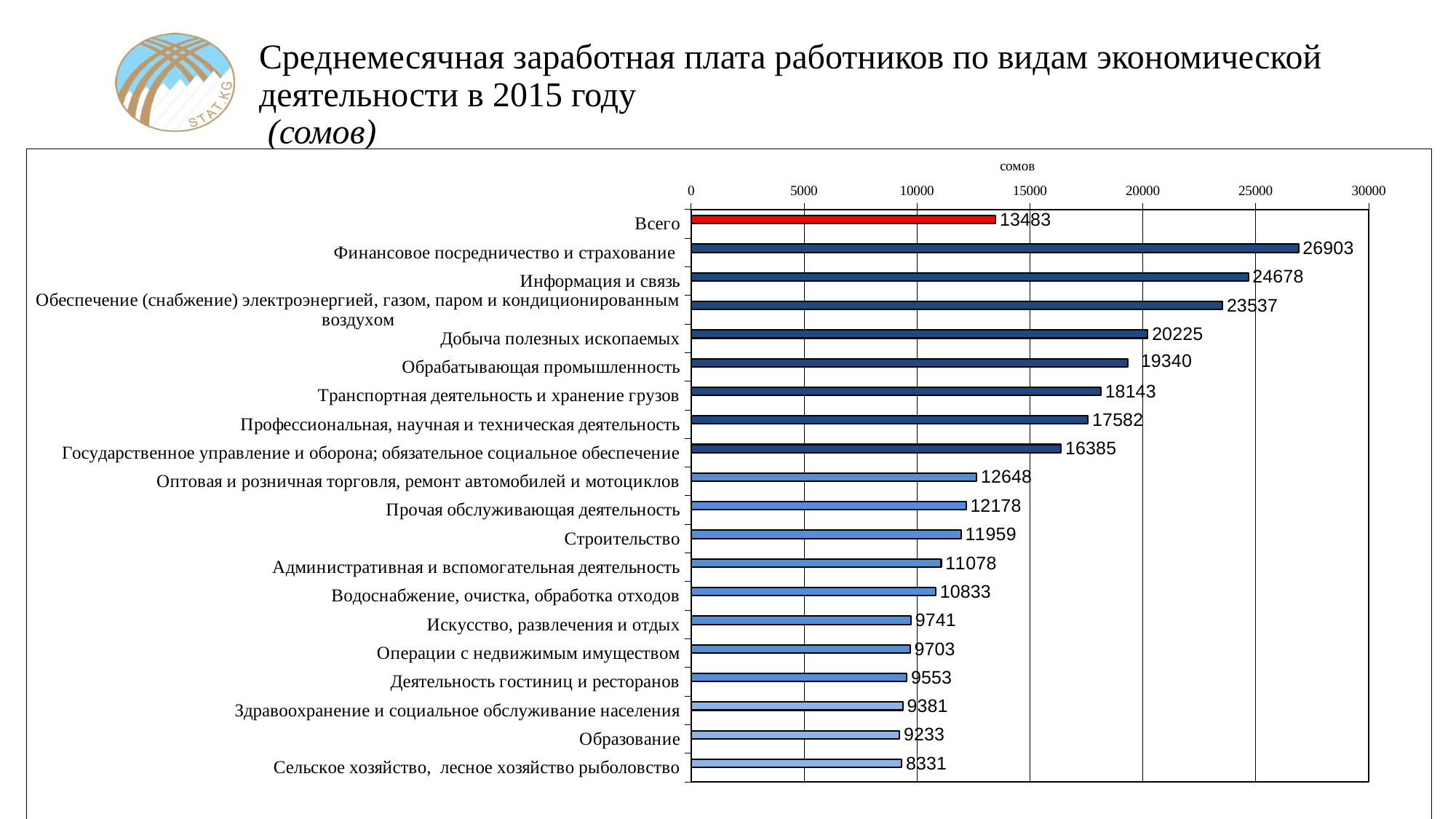
Which bar is coloured red on the chart? Всего What type of chart is shown on the slide? bar chart Is the value for Обрабатывающая промышленность greater or less than 20000? less What is the difference between the values for Информация и связь and Добыча полезных ископаемых? 4453 Which economic activity has the highest average monthly wage on the chart? Финансовое посредничество и страхование What is the value for Образование? 9233 What unit is written above the value axis of the chart? сомов Which is larger: the value for Строительство or the value for Административная и вспомогательная деятельность? Строительство What value is shown for the Всего bar? 13483 What is the average monthly wage shown for Финансовое посредничество и страхование? 26903 How many bars (categories) are plotted on the chart, including Всего? 20